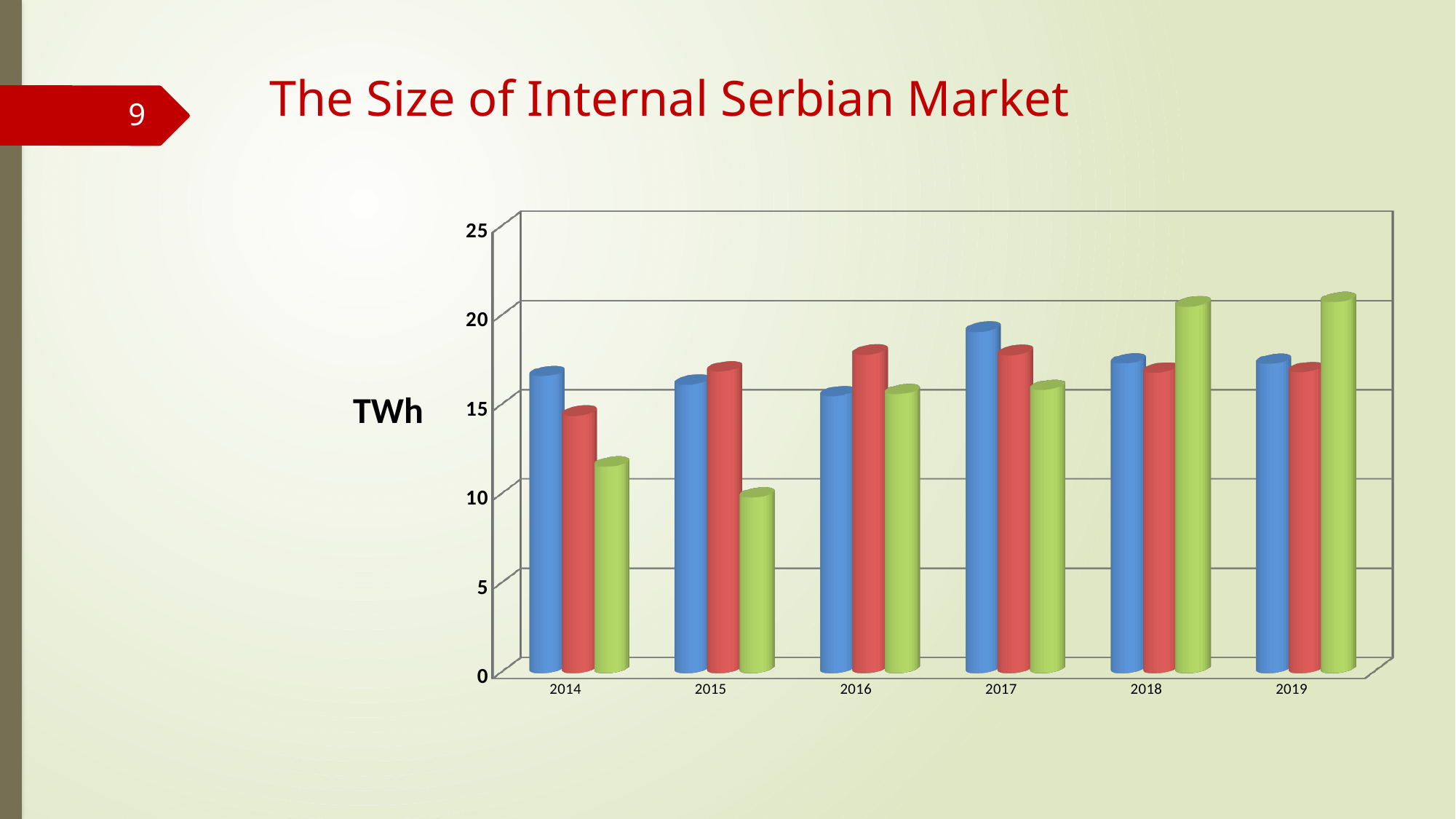
What unit is shown on the vertical axis label of the chart? TWh In which year is the red bar the lowest? 2014 In which year is the blue bar the highest? 2017 How many years are shown on the x axis of the chart? 6 Is the value of the green bar for 2014 greater or less than 10? greater How many bars are plotted for each year in the chart? 3 Is the value of the blue bar for 2017 greater or less than 20? less What is the title of the slide containing the chart? The Size of Internal Serbian Market In which year is the green bar the lowest? 2015 What kind of chart is shown on the slide? bar chart For 2019, which is larger, the green bar or the red bar? green bar Is the value of the green bar for 2019 greater or less than 20? greater